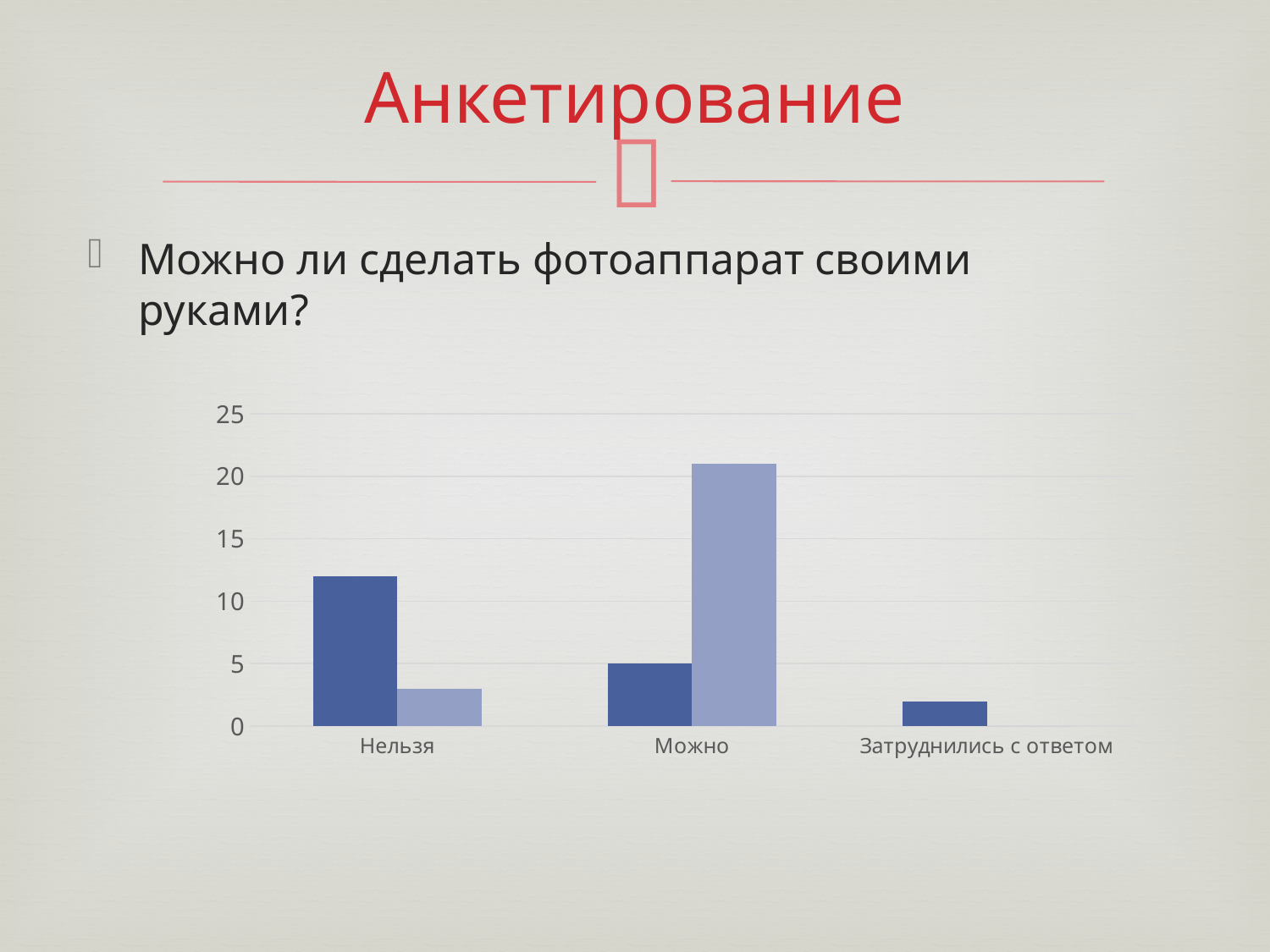
Do the dark blue bars rise or fall from left to right across the categories? fall What is the highest value shown on the vertical axis of the chart? 25 Is the dark blue bar for Нельзя greater or less than 10? greater Is the light blue bar for Можно greater or less than 20? greater Which category has the tallest bar in the chart? Можно Is the dark blue bar for Затруднились с ответом greater or less than 5? less What kind of chart is shown on the slide? bar chart Among the dark blue bars, which category has the highest value? Нельзя How many categories are shown on the x axis of the chart? 3 Among the dark blue bars, which category has the lowest value? Затруднились с ответом Which is larger: the dark blue bar for Нельзя or the dark blue bar for Можно? Нельзя